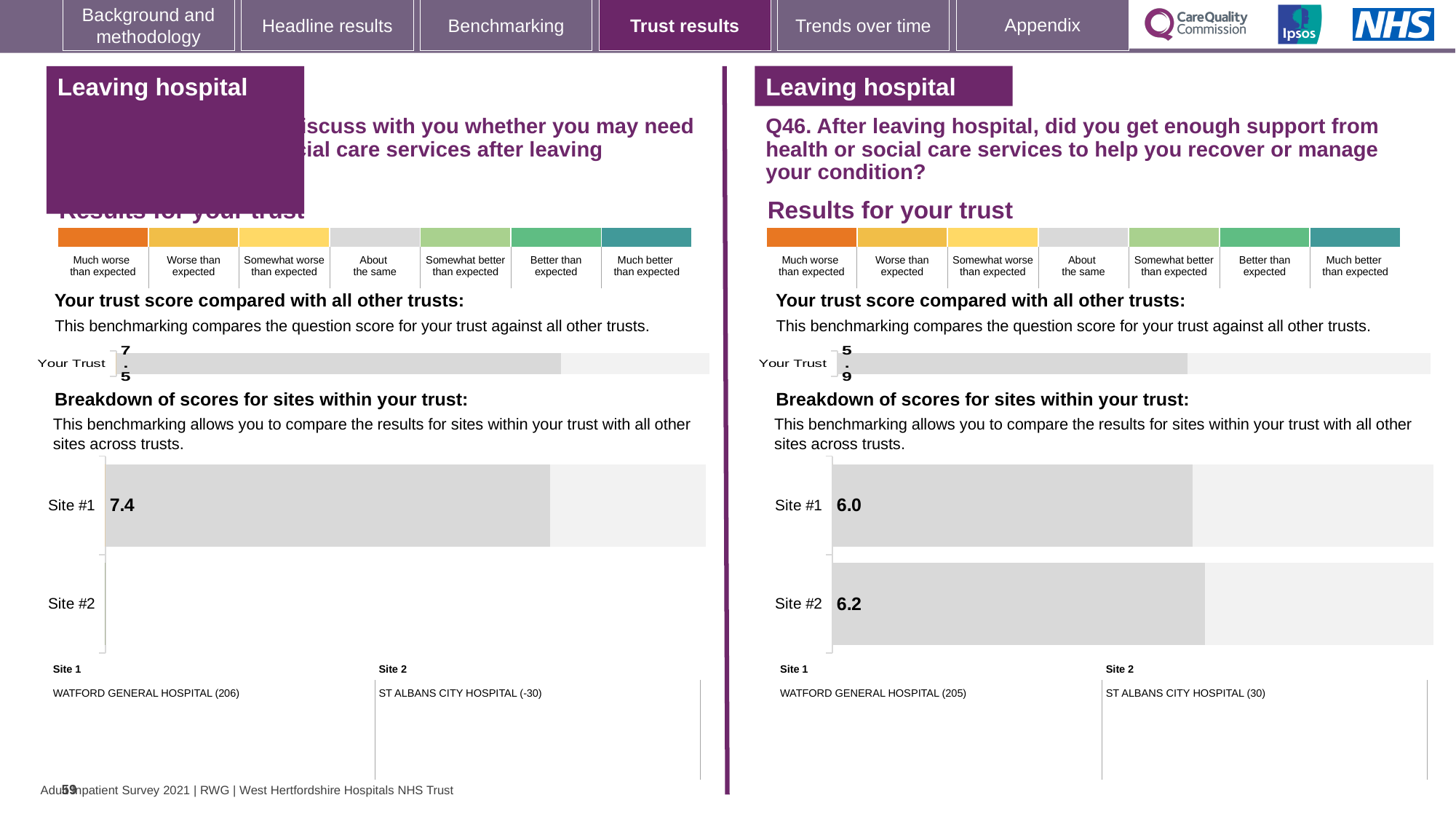
What is the difference between the 'Your Trust' score on the left-hand chart and the 'Your Trust' score on the right-hand chart (Q46)? 1.6 On the right-hand chart (Q46), which site has the higher score, Site #1 or Site #2? Site #2 On the right-hand chart (Q46), what is the score shown for Site #2 in the breakdown of scores for sites within your trust? 6.2 On the right-hand chart (Q46), which hospital is listed as Site 1 below the breakdown chart? WATFORD GENERAL HOSPITAL (205) On the left-hand chart, what is the score shown for Site #1 in the breakdown of scores for sites within your trust? 7.4 On the right-hand chart (Q46), what is the difference between the Site #2 score and the Site #1 score? 0.2 On the left-hand chart, what is the 'Your Trust' score compared with all other trusts? 7.5 On the right-hand chart (Q46), what is the score shown for Site #1 in the breakdown of scores for sites within your trust? 6.0 What type of chart is used to show the breakdown of scores for sites within your trust on the right-hand side? Bar chart Which is larger: the Site #1 score on the left-hand chart or the Site #1 score on the right-hand chart (Q46)? The left-hand chart (7.4) On the right-hand chart (Q46), what is the 'Your Trust' score compared with all other trusts? 5.9 On the right-hand chart (Q46), how many sites are listed in the breakdown of scores for sites within your trust? 2